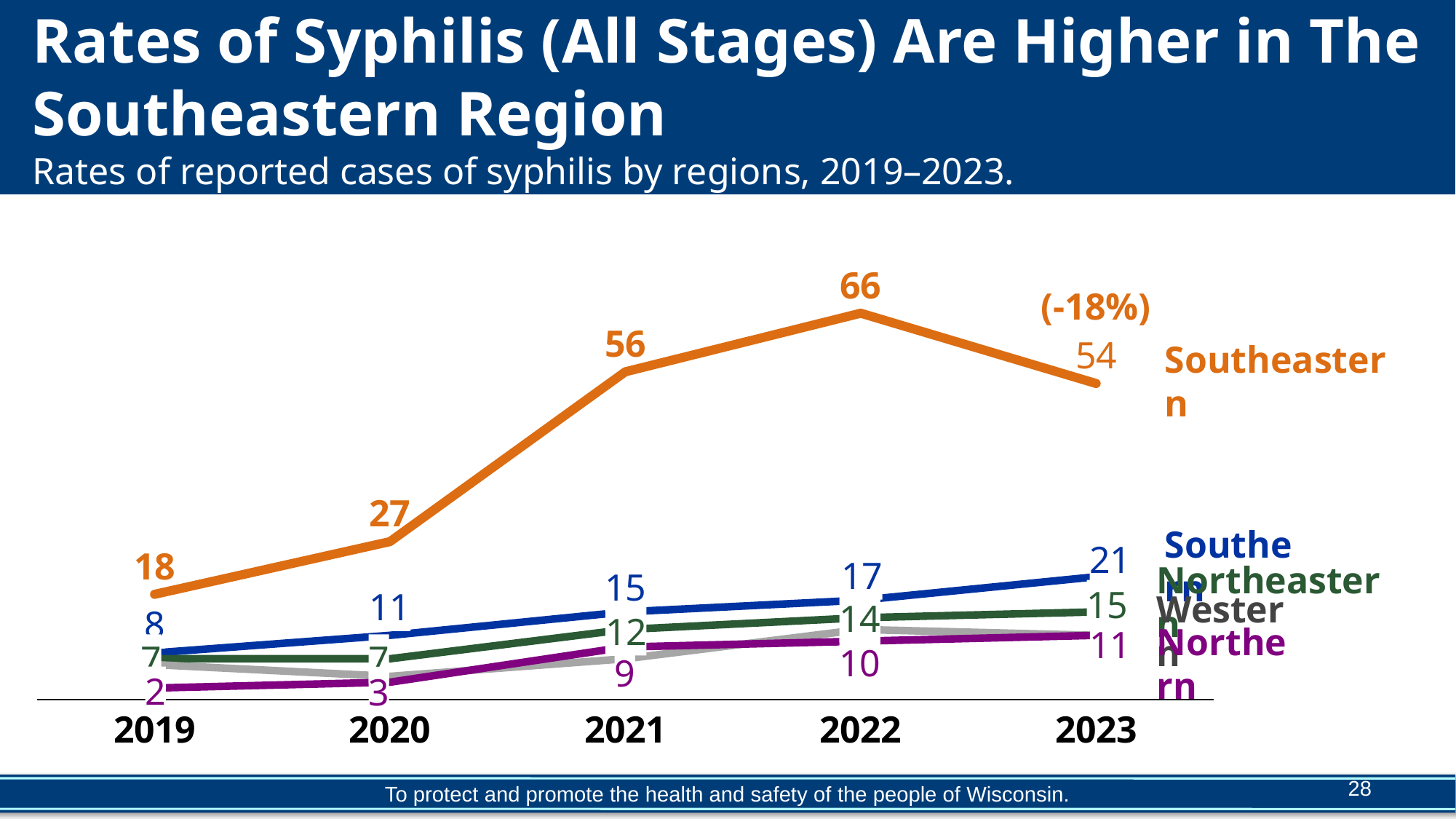
What percentage change is labelled next to the Southeastern line for 2023? (-18%) What is the Southern region's rate in 2023? 21 What kind of chart is shown on the slide? Line chart What is the Northeastern region's rate in 2021? 12 What is the Southeastern region's syphilis rate in 2022? 66 In which year was the Southeastern region's rate highest? 2022 Does the Southern region's rate rise or fall from 2019 to 2023? Rise By how much did the Southeastern region's rate fall from 2022 to 2023? 12 How many years are shown on the x axis? 5 What is the Southeastern region's rate in 2023? 54 In 2023, which region had the higher rate, Southern or Northeastern? Southern What is the Northern region's rate in 2019? 2